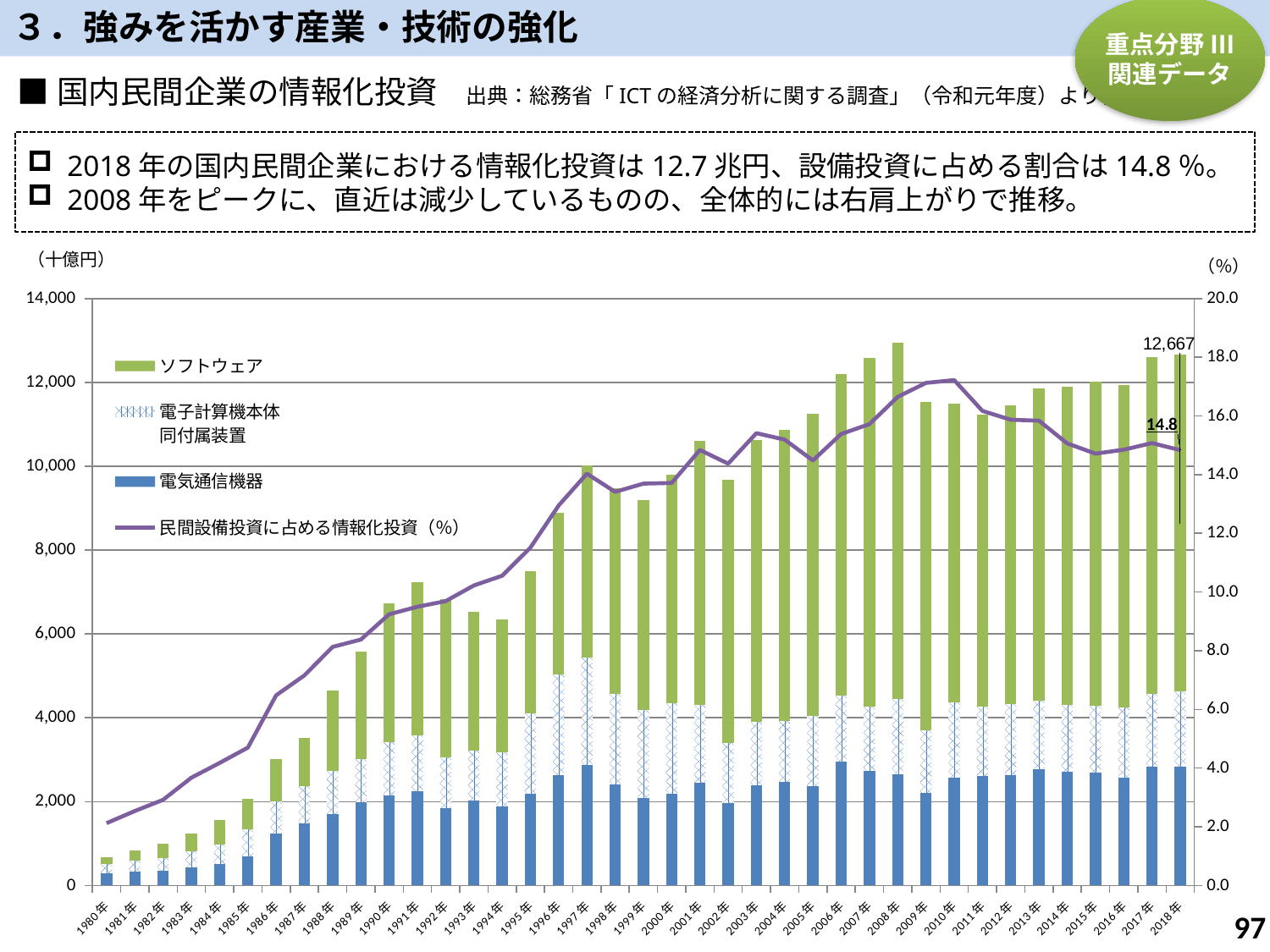
Do the total stacked bars generally rise or fall from 1980年 to 2008年? rise What is the data label shown on the total stacked bar for 2018年? 12,667 What unit is shown above the left vertical axis of the chart? 十億円 Which year has the tallest stacked bar in the chart? 2008年 Is the total stacked bar for 2008年 greater or less than 12,000? greater What value does the line 民間設備投資に占める情報化投資（%） show for 2018年? 14.8 Which year has the shortest stacked bar in the chart? 1980年 Is the total stacked bar for 1980年 greater or less than 2,000? less How many years are plotted along the x axis of the chart? 39 Which year has the larger total stacked bar, 2001年 or 2002年? 2001年 How many series does the chart legend list? 4 What kind of chart is used to show the investment amounts by category? bar chart